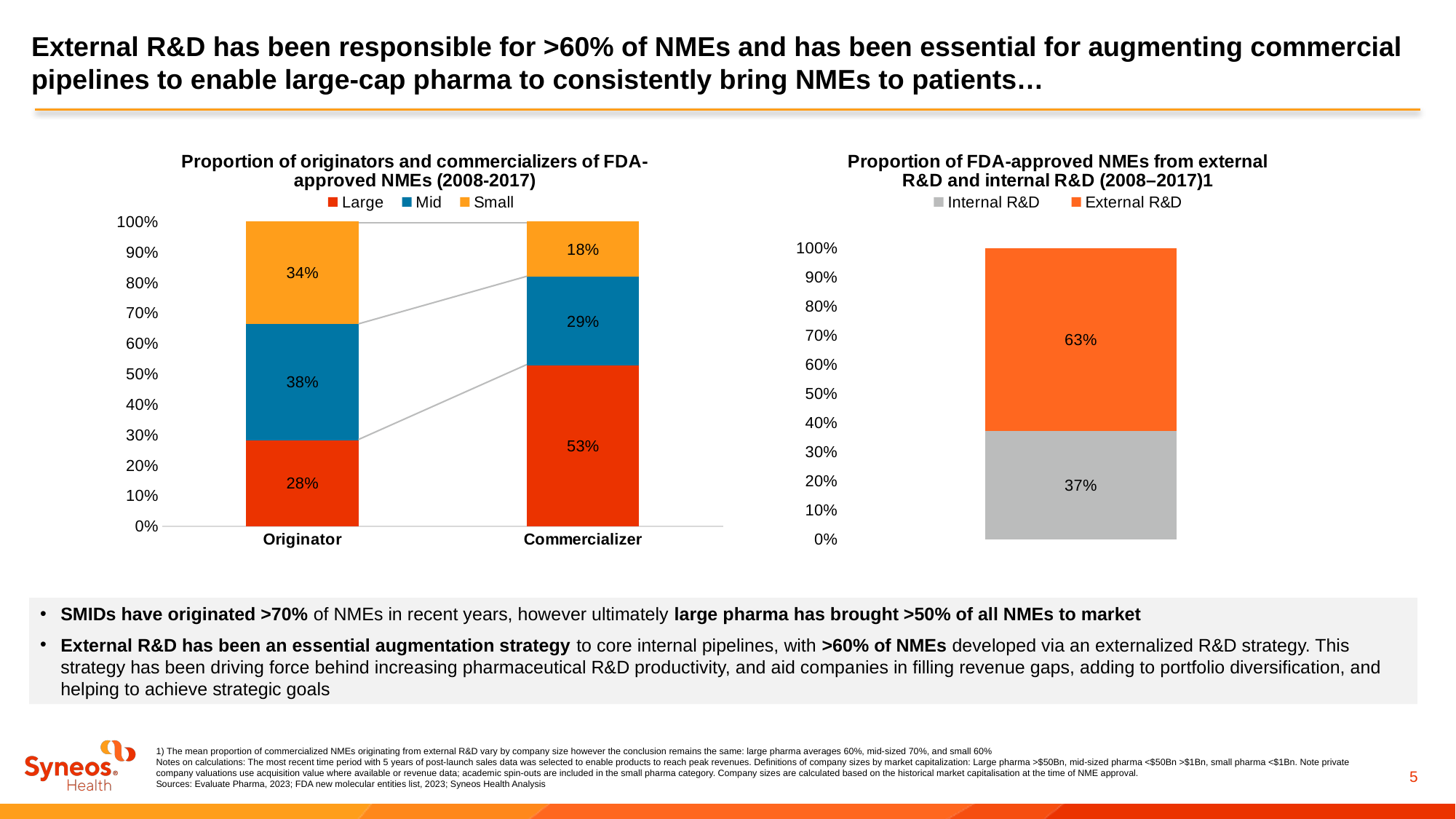
How many series does the legend of the left chart list? 3 In the left chart, is the Small share larger for Originator or Commercializer? Originator In the left chart (Proportion of originators and commercializers of FDA-approved NMEs), what is the value for Large in the Originator bar? 28% In the right chart, what is the difference between the External R&D and Internal R&D values? 26 percentage points In the left chart, what is the value for Small in the Commercializer bar? 18% In the left chart, what is the difference between the Large share for Commercializer and the Large share for Originator? 25 percentage points In the right chart (Proportion of FDA-approved NMEs from external R&D and internal R&D), what is the value for External R&D? 63% In the right chart, what is the value for Internal R&D? 37% In the left chart, which series has the smallest share of the Originator bar? Large In the left chart, which series has the largest share of the Commercializer bar? Large In the left chart, what is the value for Mid in the Originator bar? 38% What type of chart is the right chart? Stacked bar chart